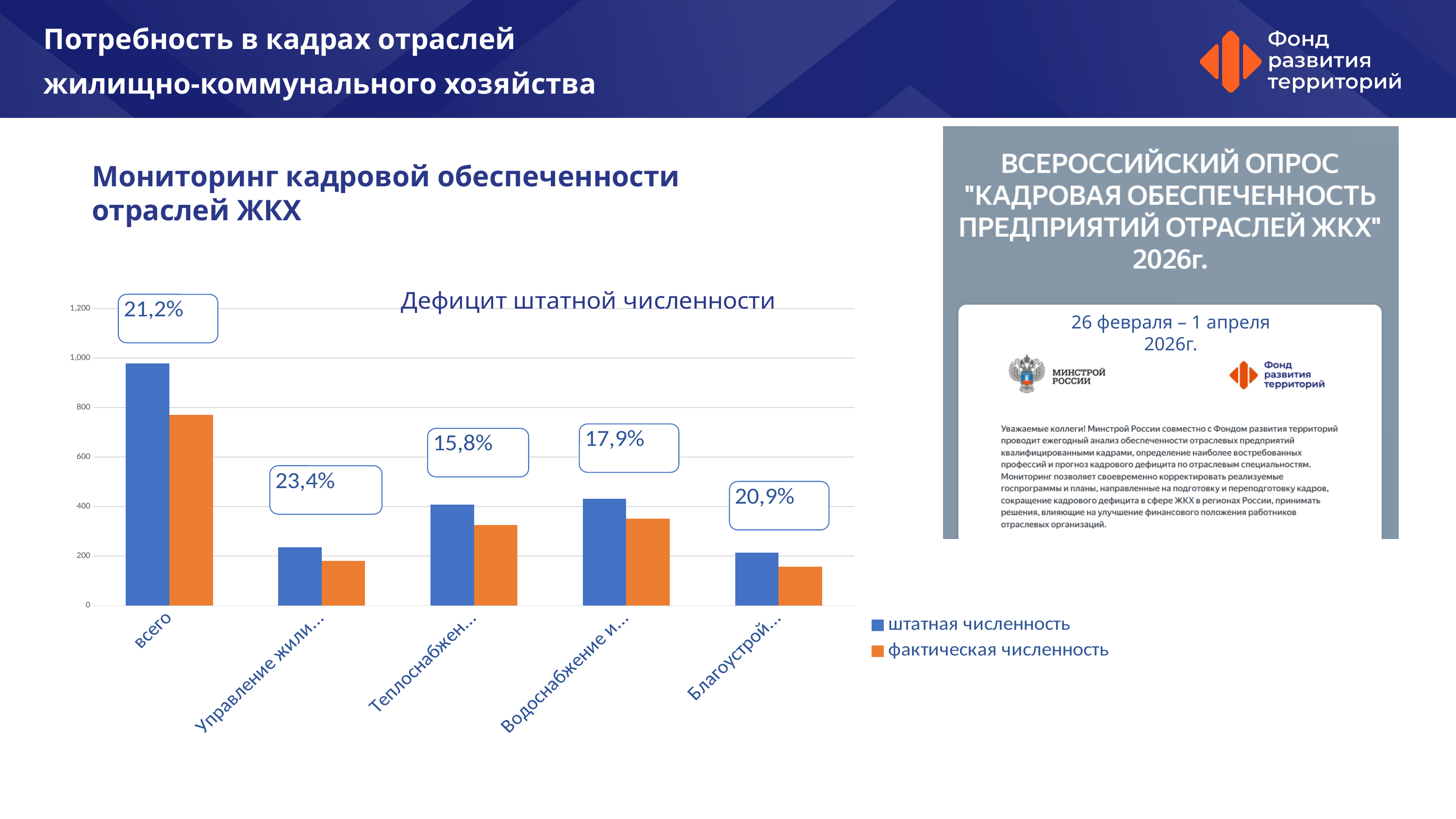
Is the фактическая численность value for the category labelled "Благоустрой..." greater or less than 200? less Is the штатная численность value for "всего" greater or less than 800? greater How many categories are shown on the x axis of the "Дефицит штатной численности" chart? 5 What percentage is shown in the callout above the "всего" bars? 21,2% Is the штатная численность value for the category labelled "Теплоснабжен..." greater or less than 600? less For the category labelled "Водоснабжение и...", which is larger: штатная численность or фактическая численность? штатная численность What kind of chart is shown under the heading "Дефицит штатной численности"? bar chart What colour represents фактическая численность in the chart legend? orange Which category has the highest штатная численность in the "Дефицит штатной численности" chart? всего How many series does the legend of the "Дефицит штатной численности" chart list? 2 Which category has the highest percentage callout in the "Дефицит штатной численности" chart? Управление жили... (23,4%)